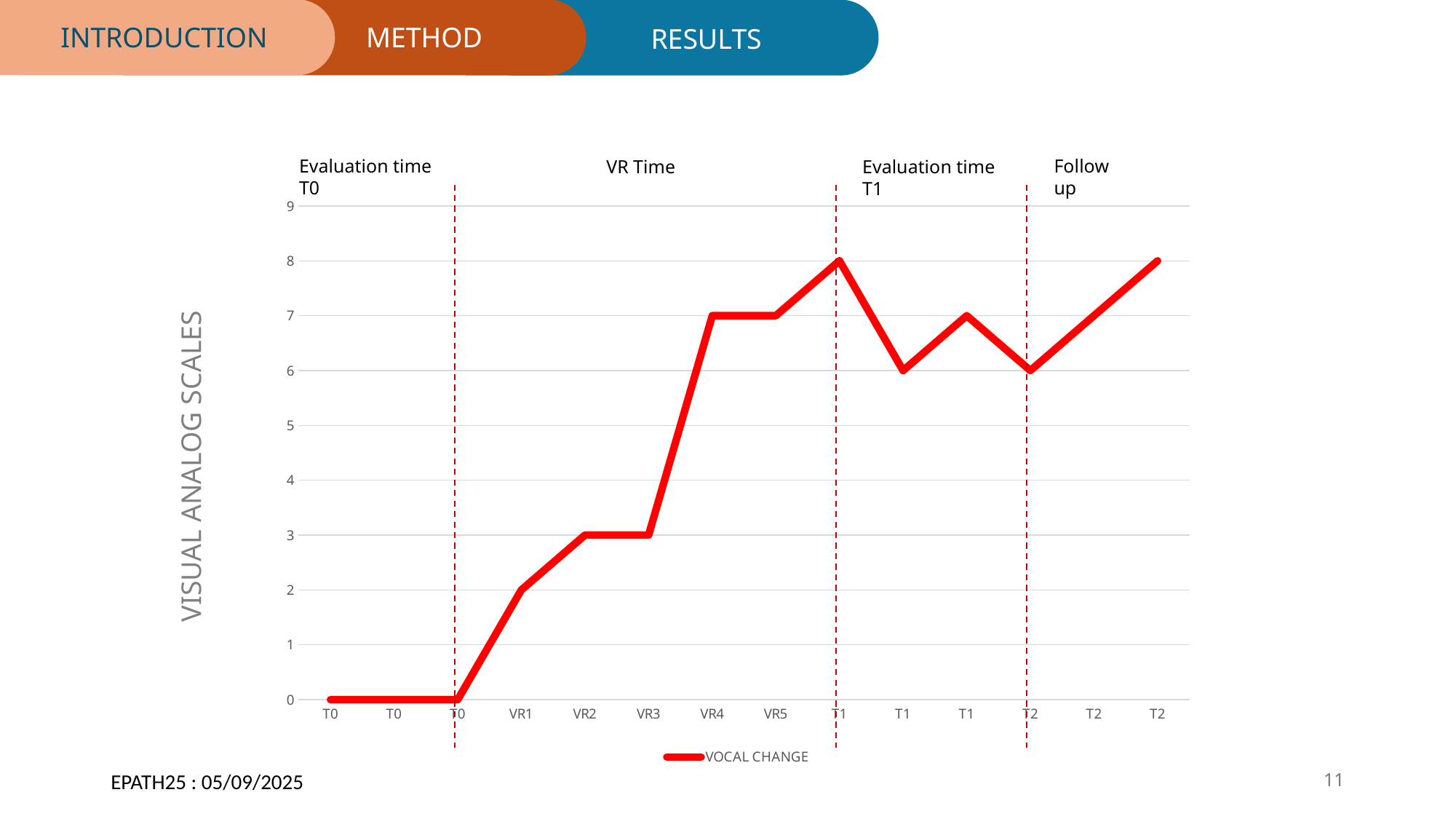
What is the VOCAL CHANGE value at VR1? 2 What kind of chart is shown on the slide? line chart Does the VOCAL CHANGE line rise or fall from VR1 to VR4? rise What is the VOCAL CHANGE value at VR2? 3 What is the lowest value on the VOCAL CHANGE line? 0 What is the difference between the values at VR4 and VR1? 5 What is the highest value reached by the VOCAL CHANGE line? 8 What is the VOCAL CHANGE value at VR4? 7 Which has the larger value, VR3 or VR5? VR5 How many series does the legend list? 1 What is the label on the vertical axis of the chart? VISUAL ANALOG SCALES How many data points are plotted along the x axis? 14